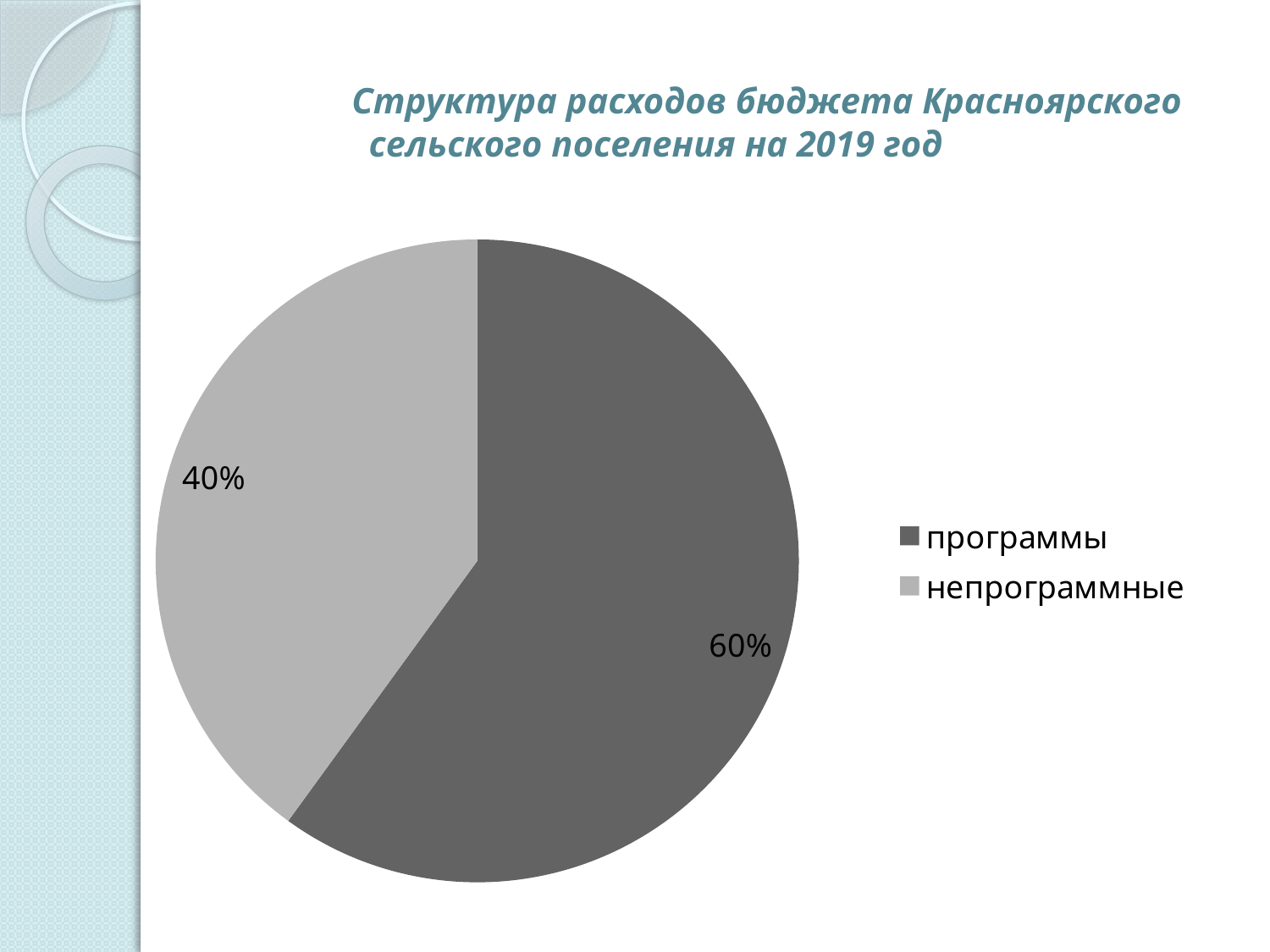
What is the difference in percentage points between the 'программы' and 'непрограммные' slices? 20% Is the value for 'непрограммные' greater or less than 50%? less Which slice is the largest? программы How many slices does the pie chart have? 2 What is the title of the slide? Структура расходов бюджета Красноярского сельского поселения на 2019 год Which legend entry is shown in the lighter grey colour? непрограммные What kind of chart is shown on the slide? pie chart How many entries does the legend list? 2 Which slice is the smallest? непрограммные Which is larger, the 'программы' slice or the 'непрограммные' slice? программы What share of the pie does the 'непрограммные' slice represent? 40% What share of the pie does the 'программы' slice represent? 60%